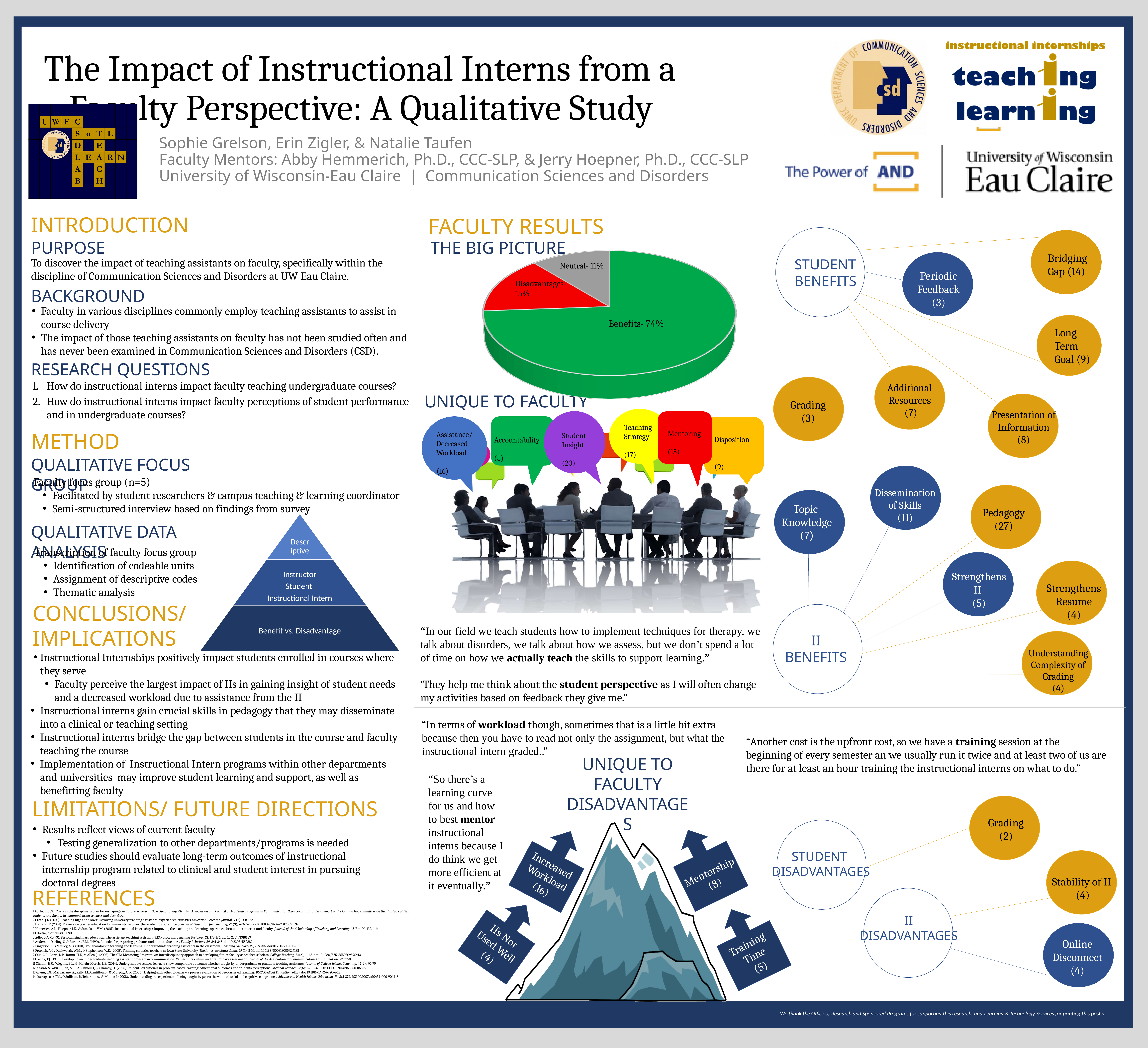
In the pie chart titled 'The Big Picture', how many percentage points larger is Disadvantages than Neutral? 4 What kind of chart is shown under 'The Big Picture' in the Faculty Results section? Pie chart How many slices does the pie chart titled 'The Big Picture' have? 3 In the pie chart titled 'The Big Picture', which category has the smallest slice? Neutral In the pie chart titled 'The Big Picture', how many percentage points larger is Benefits than Disadvantages? 59 In the pie chart titled 'The Big Picture', what percentage is shown for Disadvantages? 15% In the pie chart titled 'The Big Picture', what percentage is shown for Benefits? 74% In the pie chart titled 'The Big Picture', which is larger, Disadvantages or Neutral? Disadvantages In the pie chart titled 'The Big Picture', what colour is the Benefits slice? Green In the pie chart titled 'The Big Picture', what share of the pie does the Benefits slice represent? 74% In the pie chart titled 'The Big Picture', what percentage is shown for Neutral? 11% In the pie chart titled 'The Big Picture', which category has the largest slice? Benefits